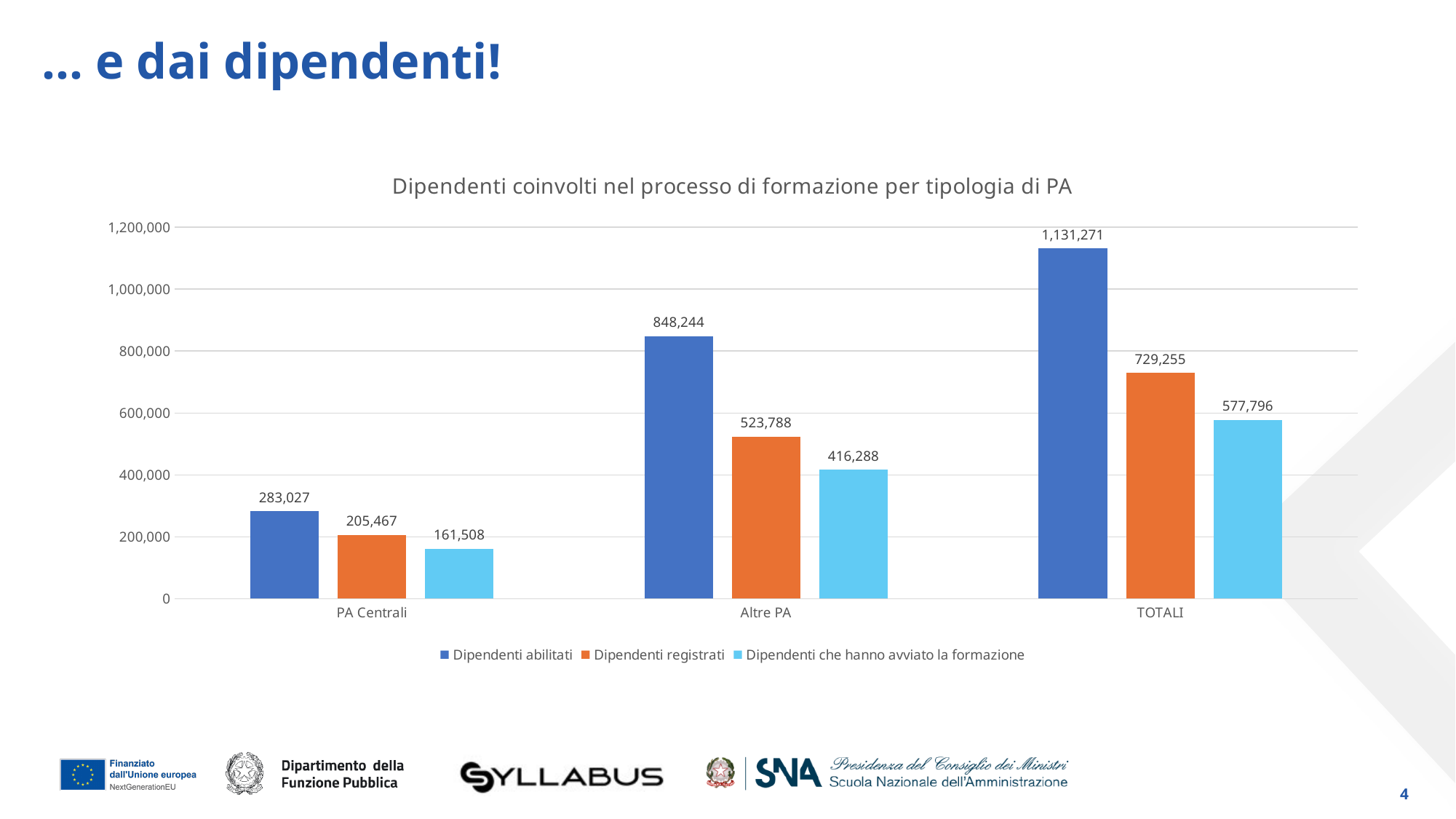
What kind of chart is shown on the slide? Bar chart What is the difference between Dipendenti abilitati and Dipendenti registrati for TOTALI? 402,016 How many series does the legend list? 3 How many categories are shown on the x axis? 3 Which category has the lowest value for Dipendenti che hanno avviato la formazione? PA Centrali What is the value of Dipendenti abilitati for Altre PA? 848,244 What is the value of Dipendenti registrati for PA Centrali? 205,467 What is the value of Dipendenti che hanno avviato la formazione for TOTALI? 577,796 Which category has the highest value for Dipendenti abilitati? TOTALI Is the value of Dipendenti abilitati for PA Centrali greater or less than 400,000? less Which is larger for Altre PA: Dipendenti registrati or Dipendenti che hanno avviato la formazione? Dipendenti registrati What is the title of the chart? Dipendenti coinvolti nel processo di formazione per tipologia di PA